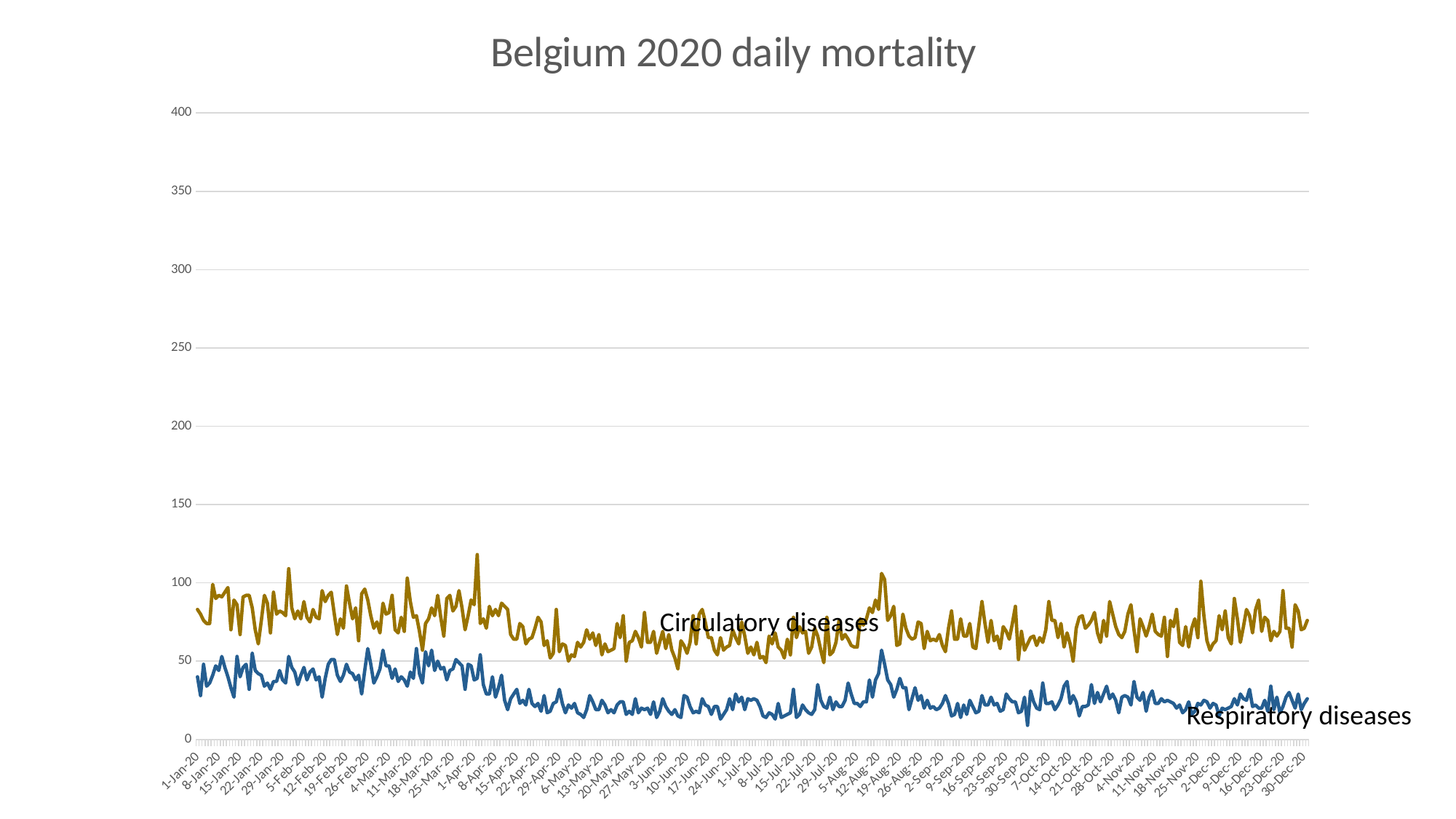
Is the value for Respiratory diseases on 8-Jul-20 greater or less than 50? less Which series has higher values throughout the year, Circulatory diseases or Respiratory diseases? Circulatory diseases Does the Respiratory diseases line ever exceed 100? no Is the highest value of the Circulatory diseases line (around early April) greater or less than 100? greater What kind of chart is shown on the slide? line chart How many data series are plotted on the chart? 2 Do the Respiratory diseases values rise or fall from January to May 2020? fall What is the title of the chart? Belgium 2020 daily mortality Which series is plotted in gold/brown: Circulatory diseases or Respiratory diseases? Circulatory diseases